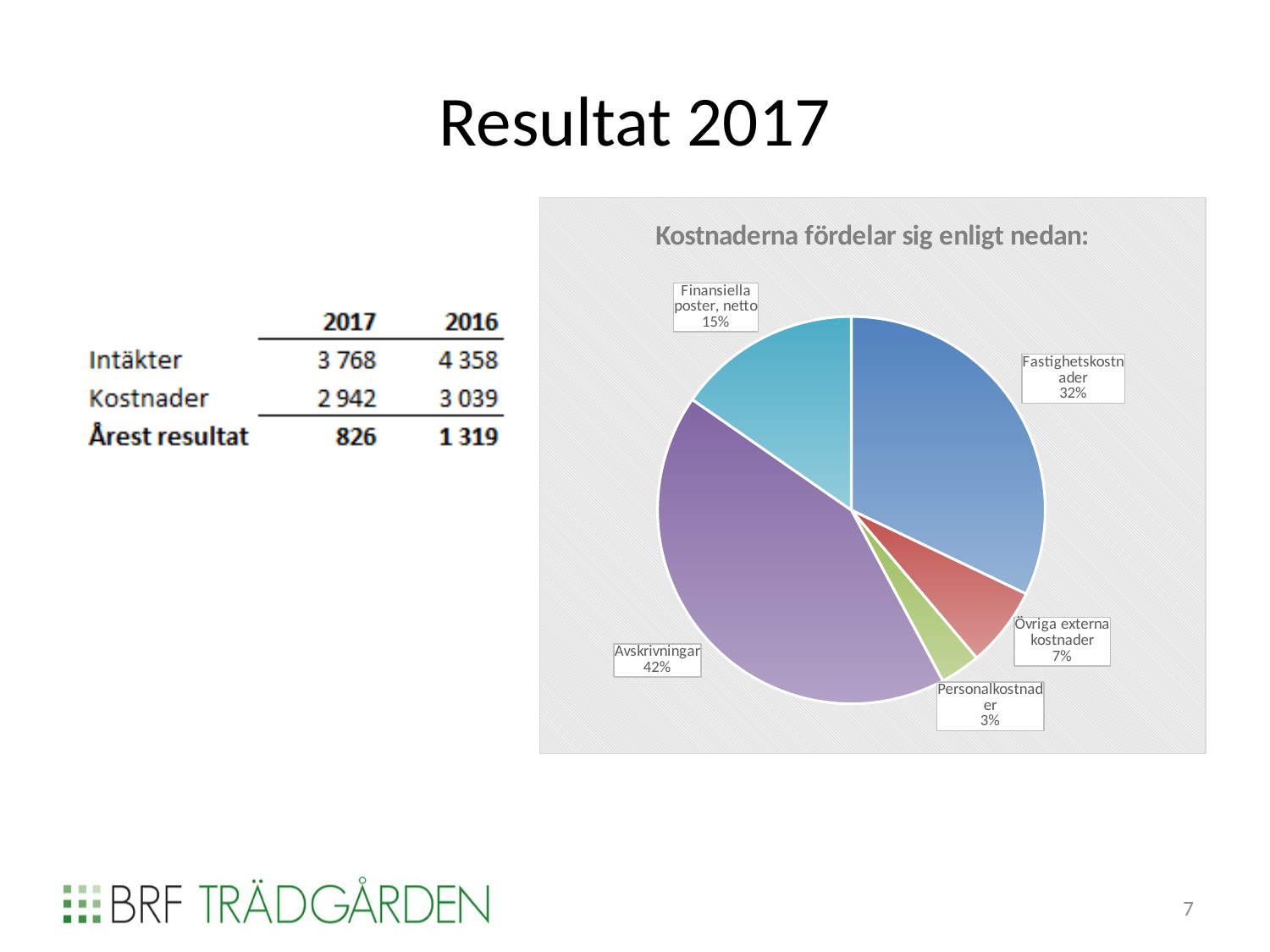
What share of the pie is Finansiella poster, netto? 15% What is the combined share of Övriga externa kostnader and Personalkostnader? 10% Which category has the smallest slice of the pie? Personalkostnader Which category has the largest slice of the pie? Avskrivningar What share of the pie is Personalkostnader? 3% Which is larger, Övriga externa kostnader or Finansiella poster, netto? Finansiella poster, netto What share of the pie is Fastighetskostnader? 32% What is the difference in percentage points between Avskrivningar and Fastighetskostnader? 10 How many slices does the pie chart have? 5 What is the title of the chart? Kostnaderna fördelar sig enligt nedan: What kind of chart is shown on the slide? pie chart